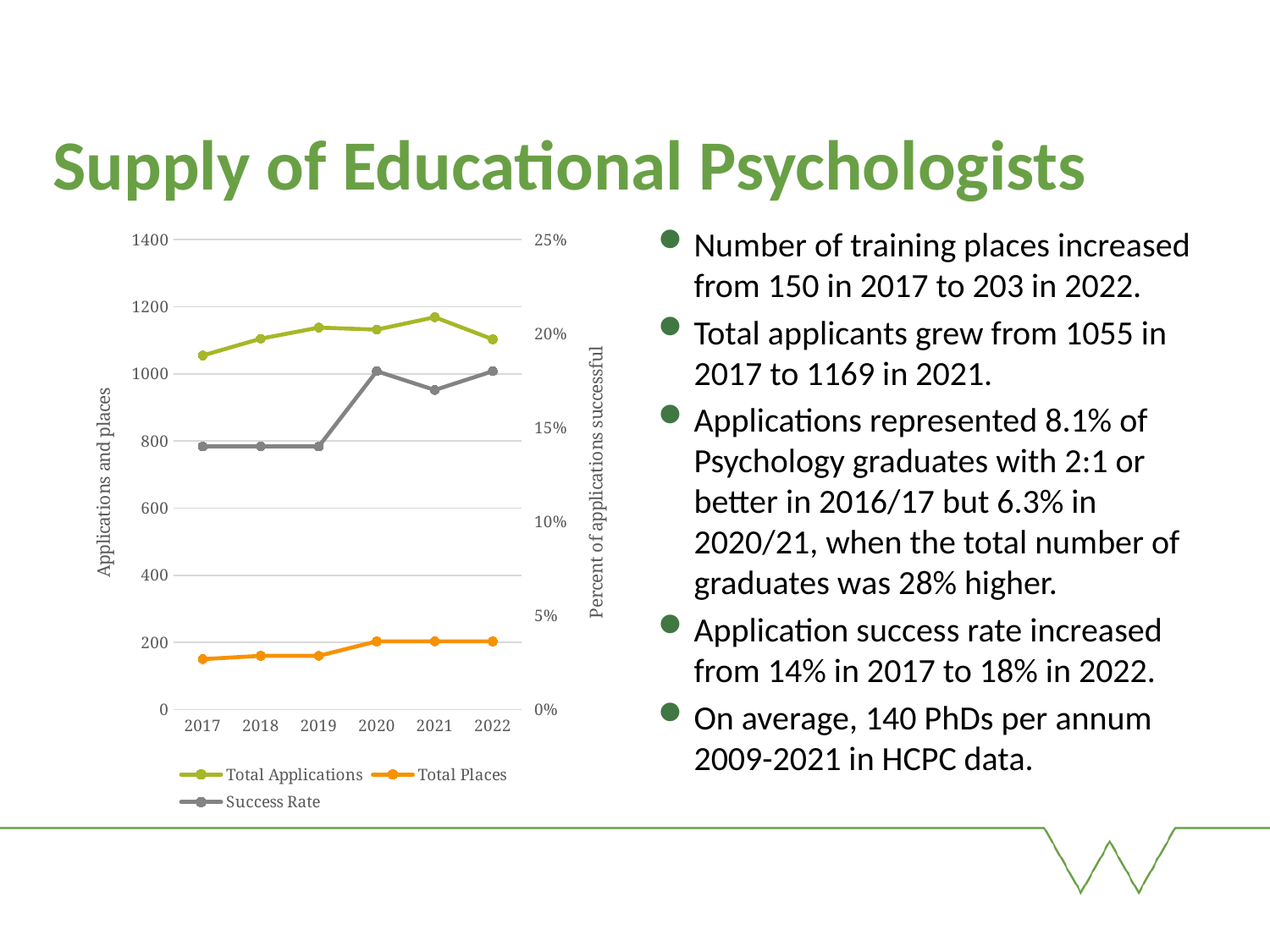
Does the Total Places series rise or fall overall from 2017 to 2022? rise In which year is Total Applications highest? 2021 Is the Success Rate in 2020 greater or less than 15%? greater In which year is Total Applications lowest? 2017 Which is larger, Total Applications in 2021 or in 2022? 2021 Is the value for Total Applications in 2022 greater or less than 1200? less How many years are plotted along the x axis of the chart? 6 How many series does the chart legend list? 3 What kind of chart is shown on the slide? line chart Is the value for Total Places in 2017 greater or less than 200? less What is the label of the right-hand vertical axis of the chart? Percent of applications successful